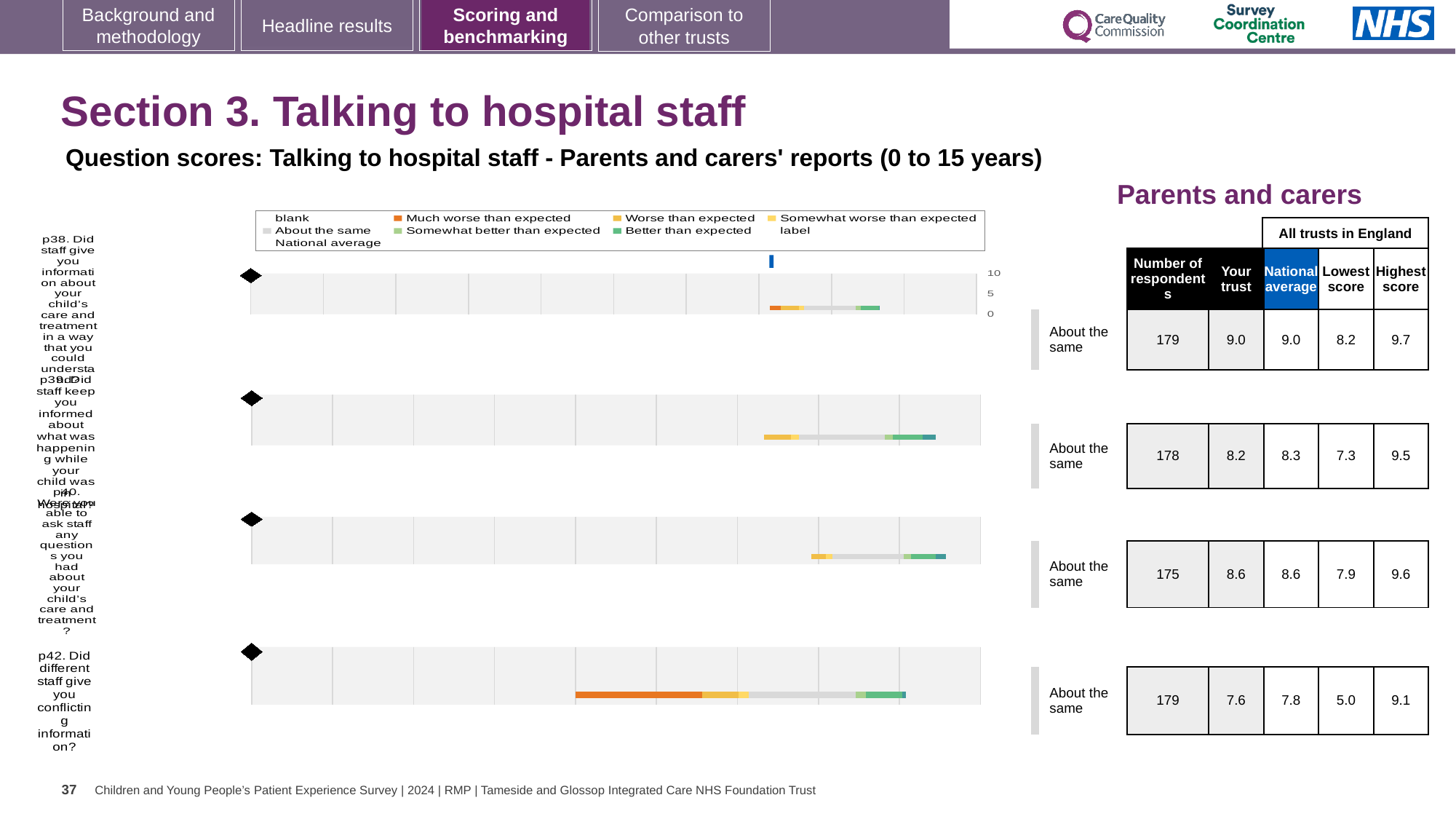
How many survey questions (charts) are shown on the slide? 4 What benchmark category is shown next to each of the four charts? About the same Which question has the lowest 'Your trust' score? p42 Which question has the highest 'Your trust' score? p38 For the p39 chart, what is the lowest score among all trusts in England? 7.3 For the p38 chart (staff giving information about your child's care and treatment), what is the 'Your trust' score? 9.0 For the p42 chart (different staff giving conflicting information), what is the national average score? 7.8 For the p40 chart (able to ask staff any questions), how many respondents are there? 175 For the p42 chart, what is the difference between the highest score and the lowest score across all trusts in England? 4.1 For the p39 chart (staff keeping you informed), which is larger: the 'Your trust' score or the national average? National average What kind of chart is used to show the question scores on this slide? bar chart How many entries does the legend above the charts list? 9